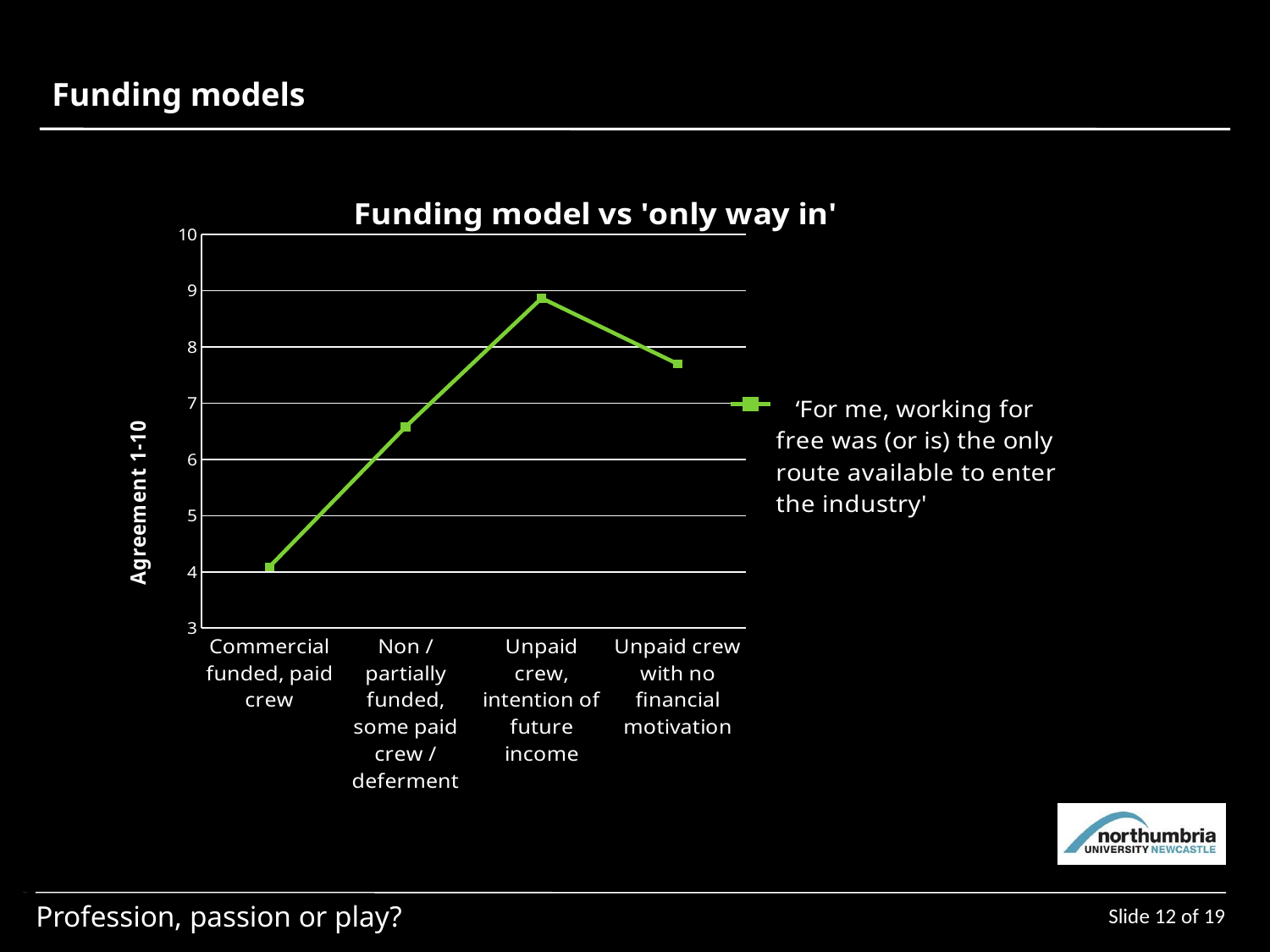
Which funding model has the highest agreement value? Unpaid crew, intention of future income Is the value for Unpaid crew with no financial motivation greater or less than 8? less Is the value for Non / partially funded, some paid crew / deferment greater or less than 6? greater What is the label on the vertical axis of the chart? Agreement 1-10 What type of chart is shown on the slide? line chart How many funding model categories are plotted on the x axis? 4 How many series does the legend list? 1 Is the value for Unpaid crew, intention of future income greater or less than 8? greater Which funding model has the lowest agreement value? Commercial funded, paid crew Which has the larger value: Non / partially funded, some paid crew / deferment or Unpaid crew with no financial motivation? Unpaid crew with no financial motivation What is the title of the chart? Funding model vs 'only way in'